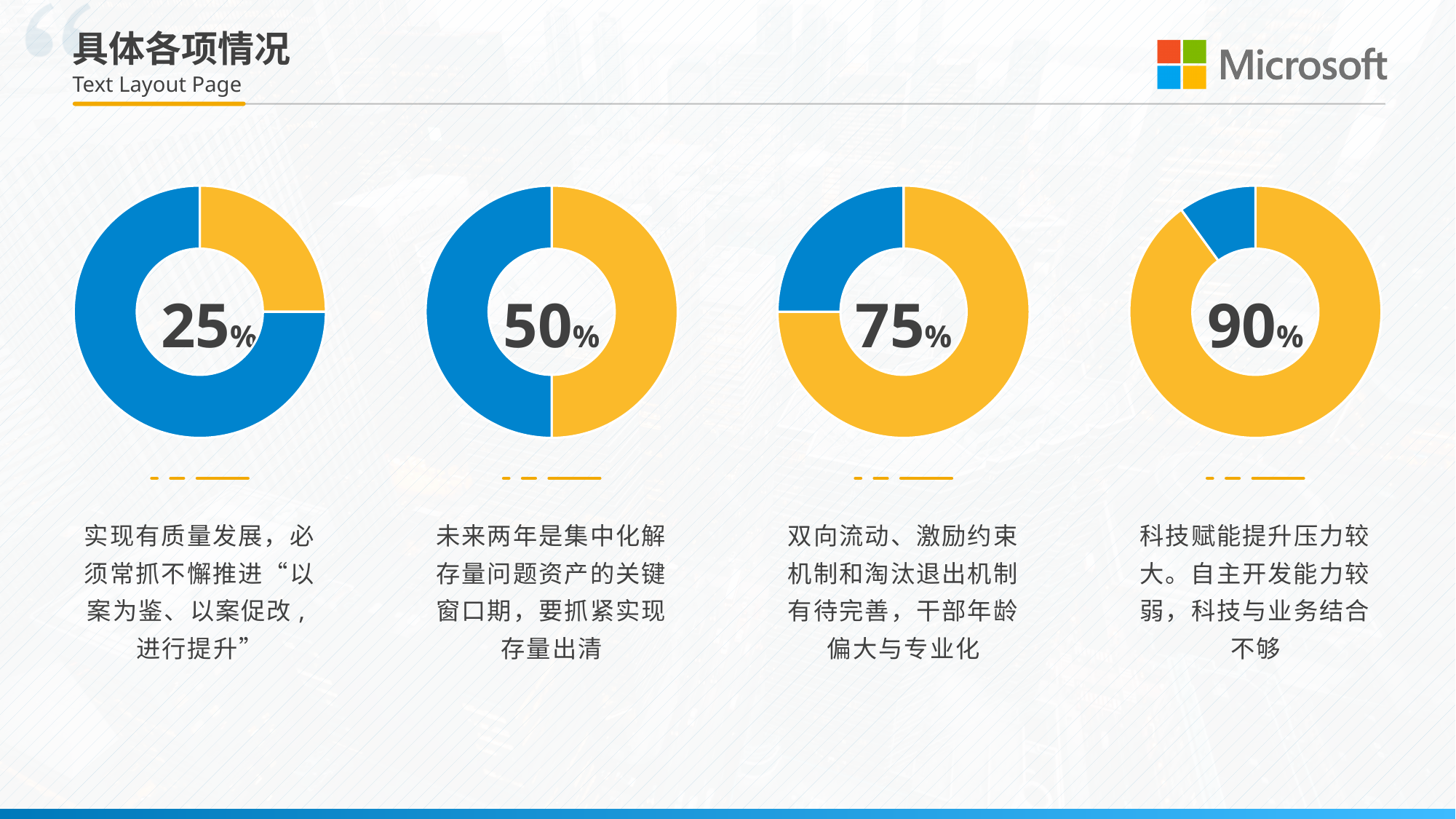
In the rightmost donut chart, what colour is the slice representing the 90% share? Yellow Which is larger: the percentage in the second donut chart from the left or the percentage in the third donut chart from the left? The third (75%) What kind of chart is used to display the percentages on this slide? Donut (pie) chart What value is shown in the centre of the leftmost donut chart? 25% What value is shown in the centre of the third donut chart from the left? 75% Do the percentages in the donut charts increase or decrease from left to right across the slide? Increase What is the difference between the percentage in the rightmost donut chart and the percentage in the leftmost donut chart? 65% What value is shown in the centre of the rightmost donut chart? 90% Which donut chart shows the lowest percentage? The leftmost one (25%) Which donut chart shows the highest percentage? The rightmost one (90%) What value is shown in the centre of the second donut chart from the left? 50% How many donut charts are on the slide? 4